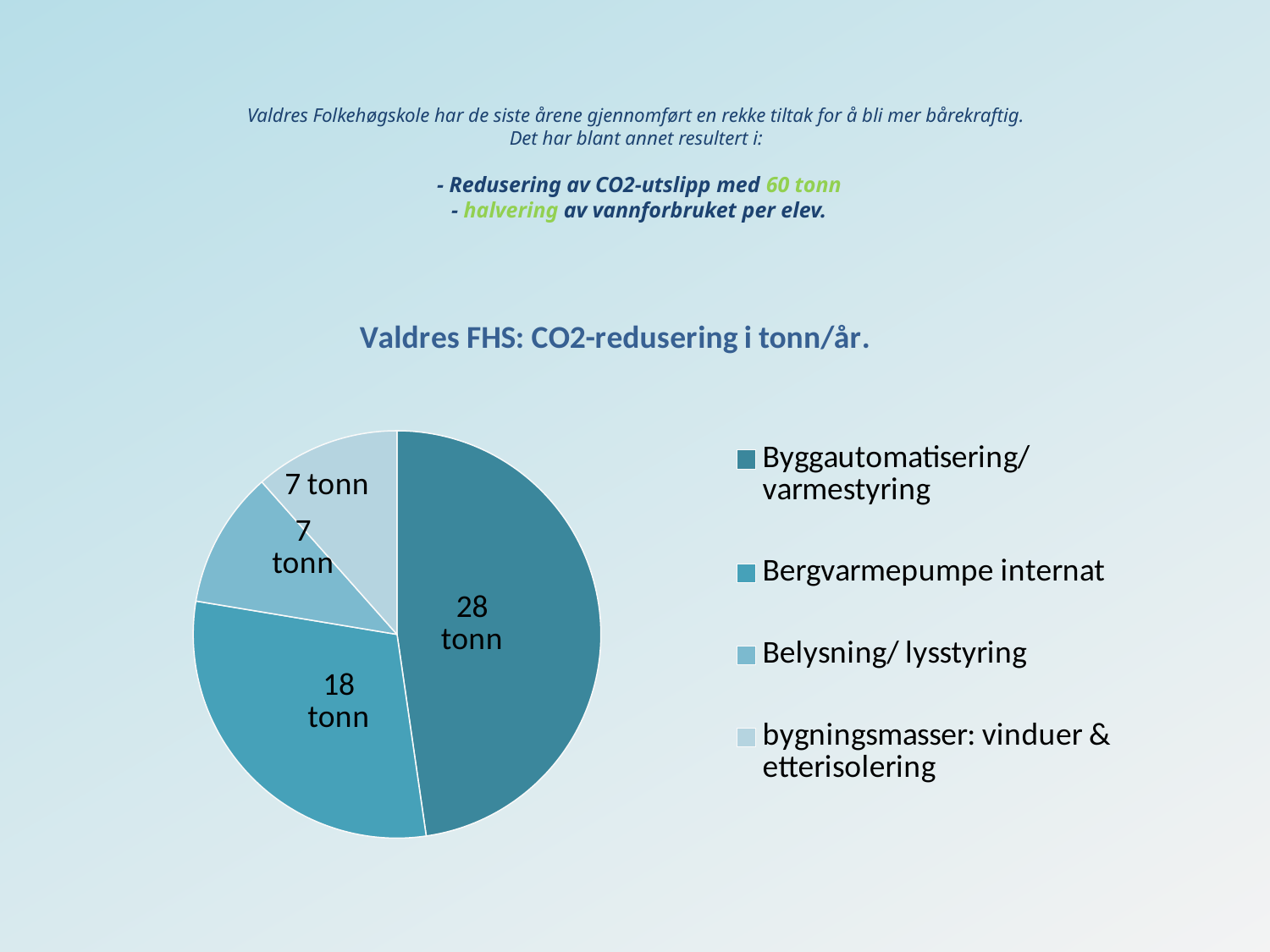
What is the title of the chart? Valdres FHS: CO2-redusering i tonn/år. What is the CO2 reduction value for bygningsmasser: vinduer & etterisolering? 7 tonn What share of the total CO2 reduction does Bergvarmepumpe internat represent? 30% What is the difference in tonn between Byggautomatisering/ varmestyring and Bergvarmepumpe internat? 10 tonn What is the CO2 reduction value for Byggautomatisering/ varmestyring? 28 tonn What kind of chart is shown on the slide? Pie chart What is the CO2 reduction value for Bergvarmepumpe internat? 18 tonn What is the total CO2 reduction across all four slices of the pie? 60 tonn Which category accounts for the largest CO2 reduction? Byggautomatisering/ varmestyring How many slices does the pie chart have? 4 Which is larger, the value for Bergvarmepumpe internat or the value for Belysning/ lysstyring? Bergvarmepumpe internat What is the CO2 reduction value for Belysning/ lysstyring? 7 tonn